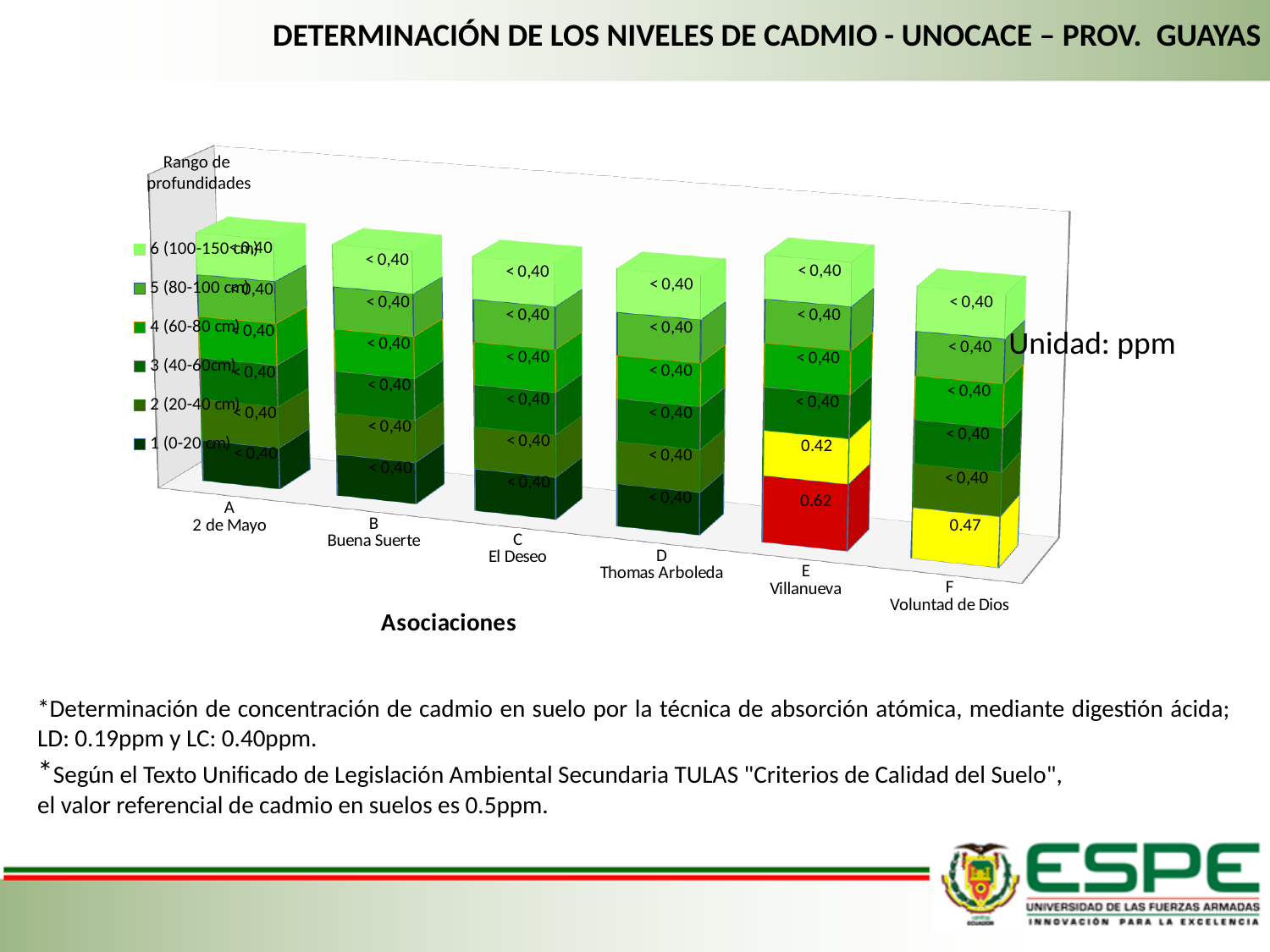
What is the cadmium value for E Villanueva in the 2 (20-40 cm) depth range? 0.42 What kind of chart is shown on the slide? Stacked bar chart What value is shown for A 2 de Mayo in the 6 (100-150 cm) depth range? < 0,40 Which association has the highest cadmium value in the 1 (0-20 cm) depth range? E Villanueva How many depth ranges does the legend list? 6 How many associations are shown along the x axis of the chart? 6 In the 1 (0-20 cm) depth range, which has the larger value: E Villanueva or F Voluntad de Dios? E Villanueva What is the cadmium value for E Villanueva in the 1 (0-20 cm) depth range? 0.62 What is the title of the x axis of the chart? Asociaciones What is the cadmium value for F Voluntad de Dios in the 1 (0-20 cm) depth range? 0.47 What unit is indicated for the values in the chart? ppm What is the difference between the 0-20 cm values of E Villanueva and F Voluntad de Dios? 0.15